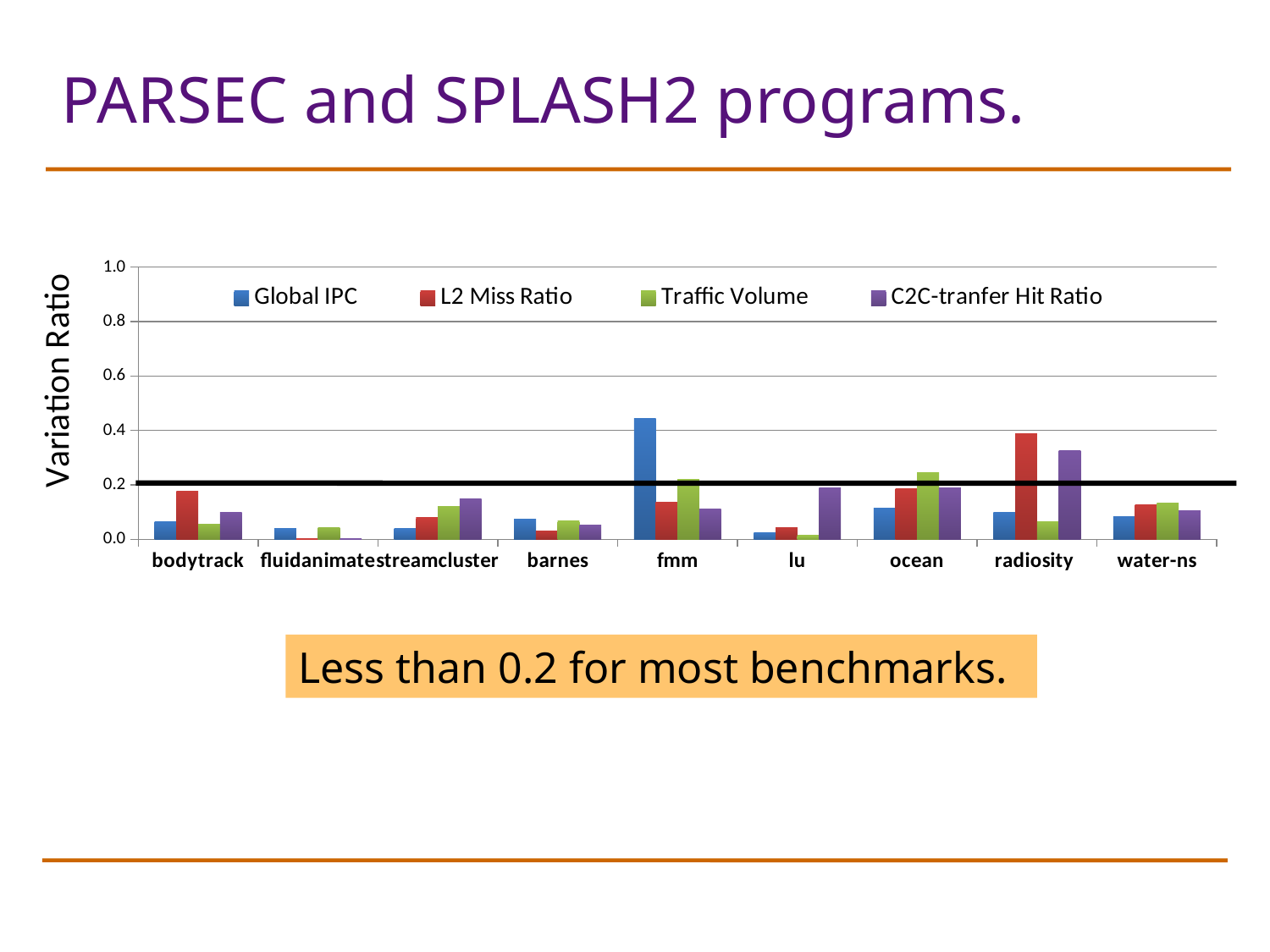
Is the Global IPC value for fmm greater or less than 0.4? greater Which benchmark has the lowest L2 Miss Ratio variation ratio? fluidanimate How many series does the legend list? 4 What is the label on the y axis? Variation Ratio What kind of chart is shown on the slide? bar chart Which benchmark has the highest L2 Miss Ratio variation ratio? radiosity Is the Global IPC value for lu greater or less than 0.2? less Which benchmark has the highest C2C-tranfer Hit Ratio variation ratio? radiosity Is the L2 Miss Ratio value for radiosity greater or less than 0.2? greater Which benchmark has the highest Global IPC variation ratio? fmm For fmm, which is larger: Global IPC or L2 Miss Ratio? Global IPC How many benchmark categories are shown on the x axis? 9